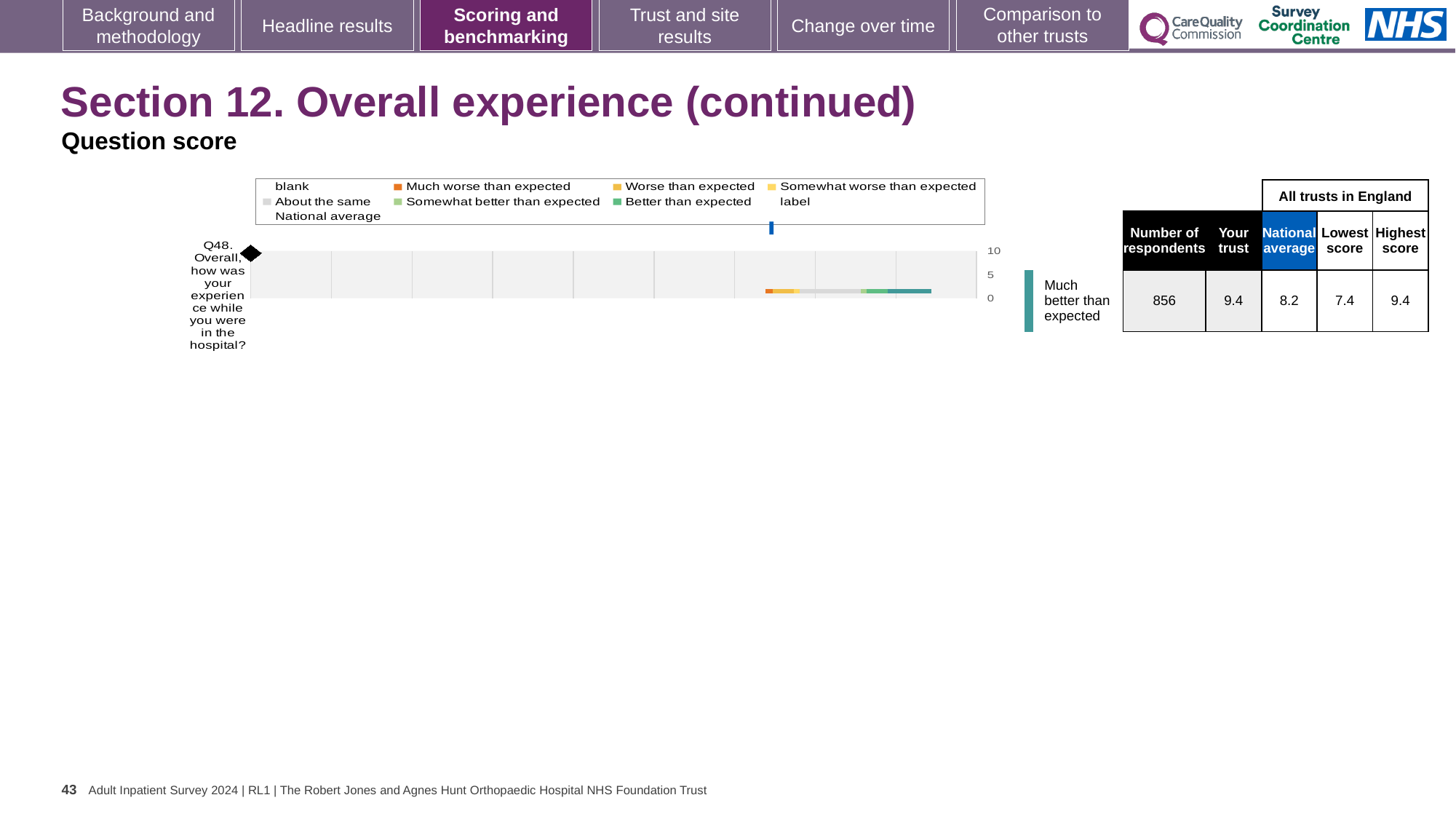
According to the table next to the chart, what is the national average score for Q48? 8.2 How many questions are plotted on the chart? 1 What is the highest value shown on the chart's axis? 10 According to the table next to the chart, what is the lowest score among all trusts in England for Q48? 7.4 How many respondents answered Q48, according to the table next to the chart? 856 What is the difference between the 'Your trust' score and the national average for Q48? 1.2 Which is larger for Q48: the 'Your trust' score or the national average? Your trust What kind of chart is used to show the Q48 question score? bar chart According to the table next to the chart, what is the highest score among all trusts in England for Q48? 9.4 Which question is plotted on the chart? Q48. Overall, how was your experience while you were in the hospital? According to the table next to the chart, what is the 'Your trust' score for Q48? 9.4 What benchmark category is the trust's Q48 score assigned to on the slide? Much better than expected